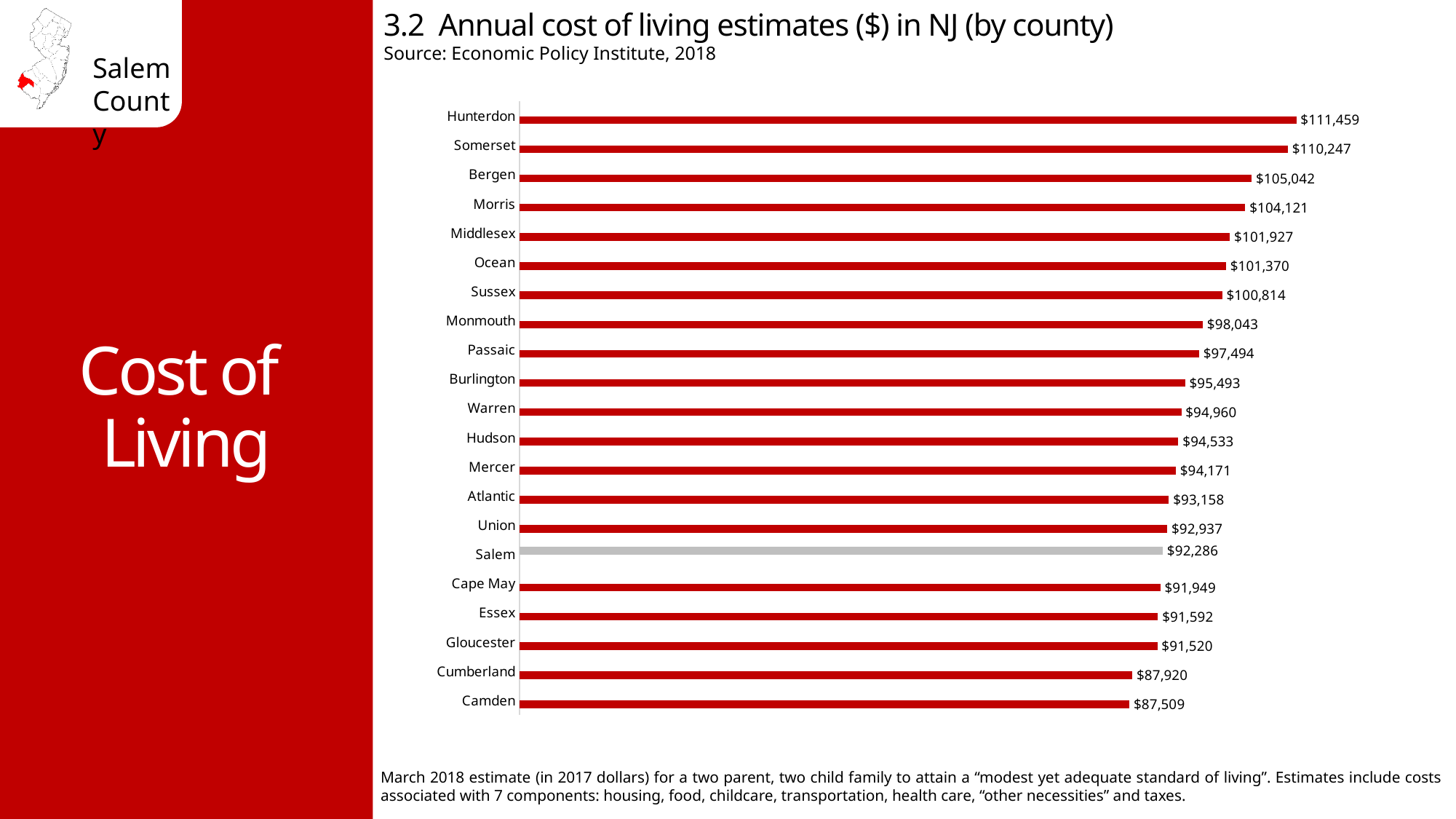
Which county has the lowest annual cost of living estimate? Camden How many counties are shown in the chart? 21 Which county has the highest annual cost of living estimate? Hunterdon Which county has a higher cost of living estimate, Morris or Monmouth? Morris What kind of chart is used to show the cost of living estimates? Bar chart Which county has a higher cost of living estimate, Gloucester or Cumberland? Gloucester Which county's bar is shown in grey rather than red? Salem What is the difference between the cost of living estimates for Salem and Cumberland? $4,366 What is the annual cost of living estimate for Bergen County? $105,042 What is the annual cost of living estimate for Salem County? $92,286 What is the source of the data shown in the chart? Economic Policy Institute, 2018 What is the difference between the cost of living estimates for Hunterdon and Camden? $23,950